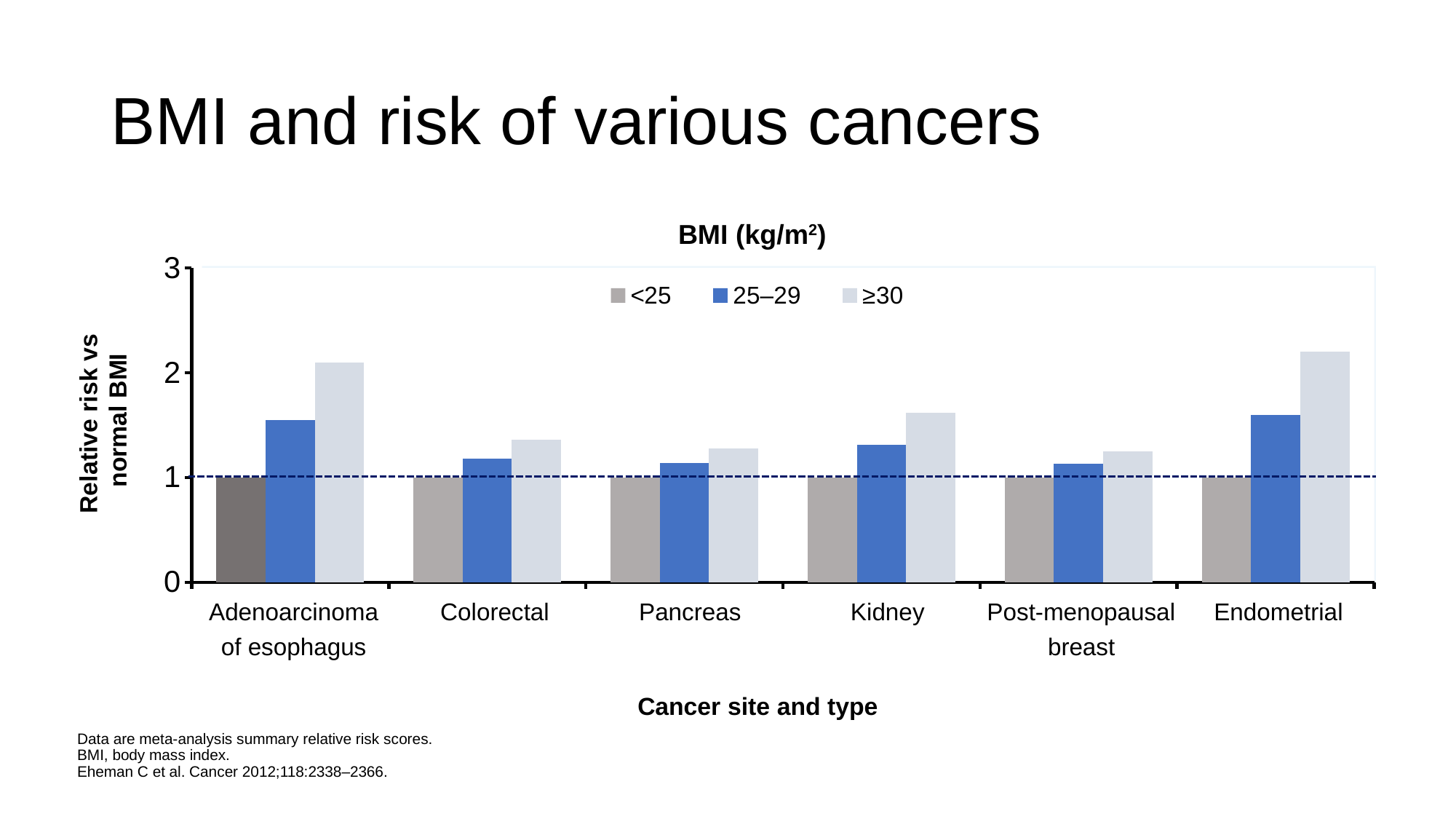
How many series does the legend list? 3 What is the relative risk for the <25 BMI group for Colorectal cancer? 1 For the 25–29 BMI group, which has the larger relative risk: Endometrial or Pancreas? Endometrial Is the relative risk for the ≥30 BMI group for Colorectal cancer greater or less than 2? less Which cancer site has the highest relative risk for the ≥30 BMI group? Endometrial How many cancer site categories are shown on the x axis? 6 Is the relative risk for the ≥30 BMI group for Kidney cancer greater or less than 2? less For the ≥30 BMI group, which has the larger relative risk: Kidney or Colorectal? Kidney Is the relative risk for the ≥30 BMI group for Endometrial cancer greater or less than 2? greater What is the title of the y axis? Relative risk vs normal BMI What are the three BMI groups listed in the legend? <25, 25–29, ≥30 What kind of chart is shown on the slide? Bar chart